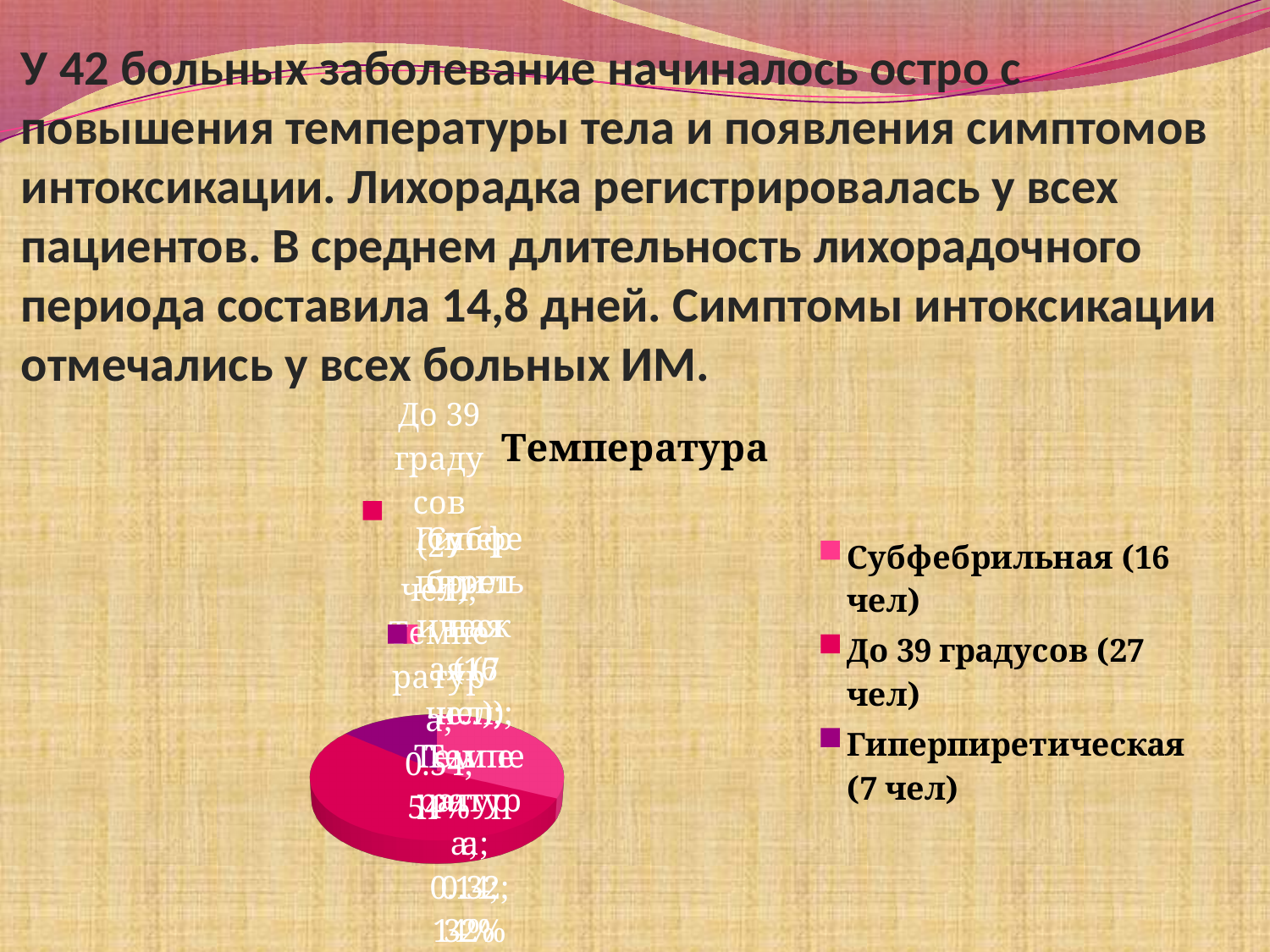
According to the legend, how many people are in the До 39 градусов category? 27 чел By how many people does the До 39 градусов category exceed the Субфебрильная category? 11 How many entries does the chart legend list? 3 Which category has more people: Субфебрильная or Гиперпиретическая? Субфебрильная What kind of chart is shown on the slide? pie chart What is the title of the chart? Температура Which category has the smallest number of people according to the legend? Гиперпиретическая According to the legend, how many people are in the Гиперпиретическая category? 7 чел How many slices does the pie chart have? 3 According to the legend, how many people are in the Субфебрильная category? 16 чел Which category has the largest number of people according to the legend? До 39 градусов Which legend entry is listed first in the chart legend? Субфебрильная (16 чел)